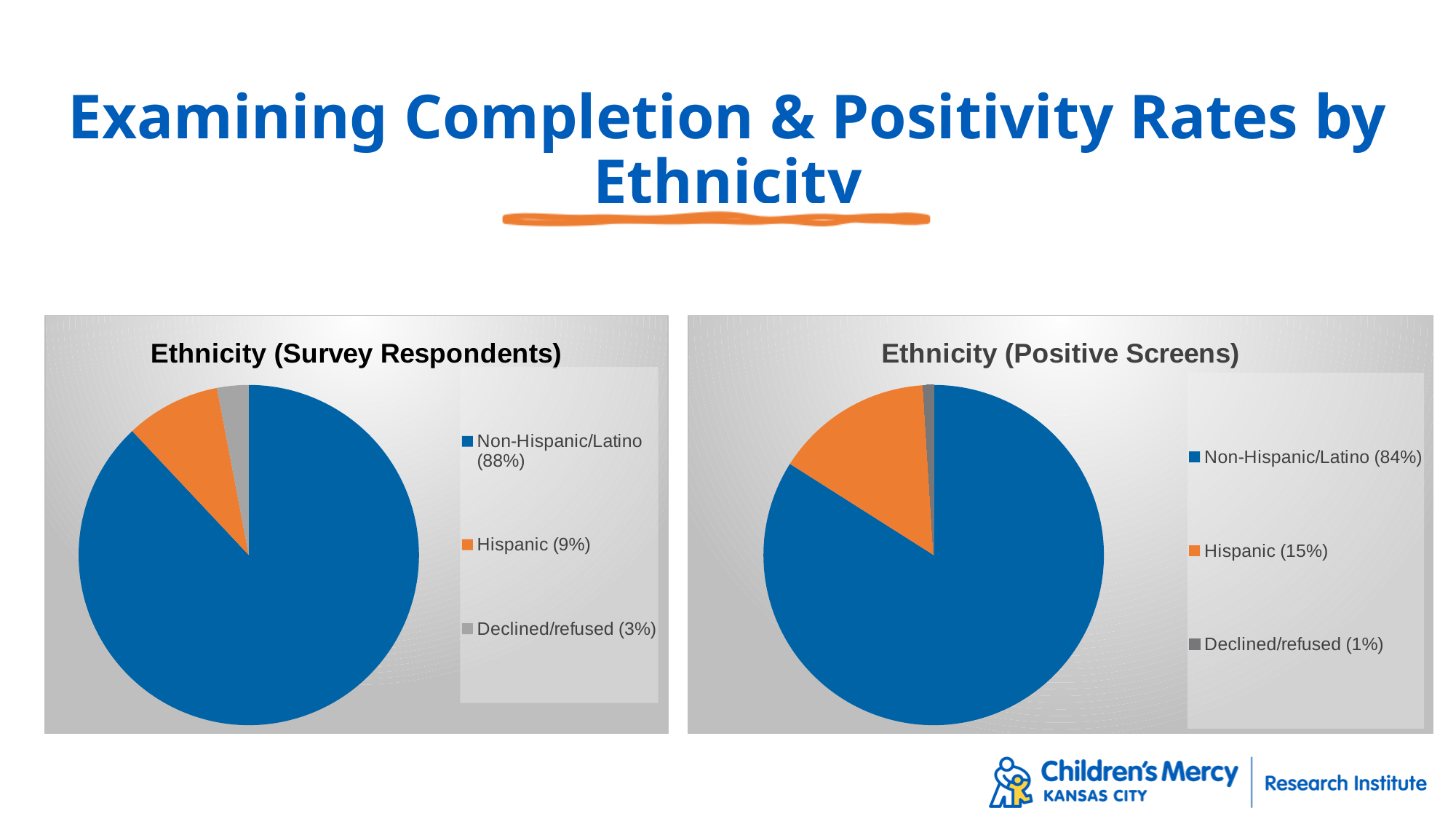
How many categories does the 'Ethnicity (Positive Screens)' chart show? 3 In the 'Ethnicity (Survey Respondents)' chart, which category has the smallest slice? Declined/refused In the 'Ethnicity (Survey Respondents)' chart, what share of respondents are Non-Hispanic/Latino? 88% In the 'Ethnicity (Survey Respondents)' chart, what percentage Declined/refused? 3% What type of chart is the 'Ethnicity (Survey Respondents)' chart? Pie chart In the 'Ethnicity (Survey Respondents)' chart, what percentage is Hispanic? 9% In the 'Ethnicity (Positive Screens)' chart, what share is Non-Hispanic/Latino? 84% In the 'Ethnicity (Positive Screens)' chart, what percentage is Hispanic? 15% Is the Non-Hispanic/Latino share larger in the 'Ethnicity (Survey Respondents)' chart or the 'Ethnicity (Positive Screens)' chart? Ethnicity (Survey Respondents) In the 'Ethnicity (Positive Screens)' chart, what percentage Declined/refused? 1% What is the difference between the Hispanic share in the 'Ethnicity (Positive Screens)' chart and the Hispanic share in the 'Ethnicity (Survey Respondents)' chart? 6% In the 'Ethnicity (Positive Screens)' chart, which category has the largest slice? Non-Hispanic/Latino